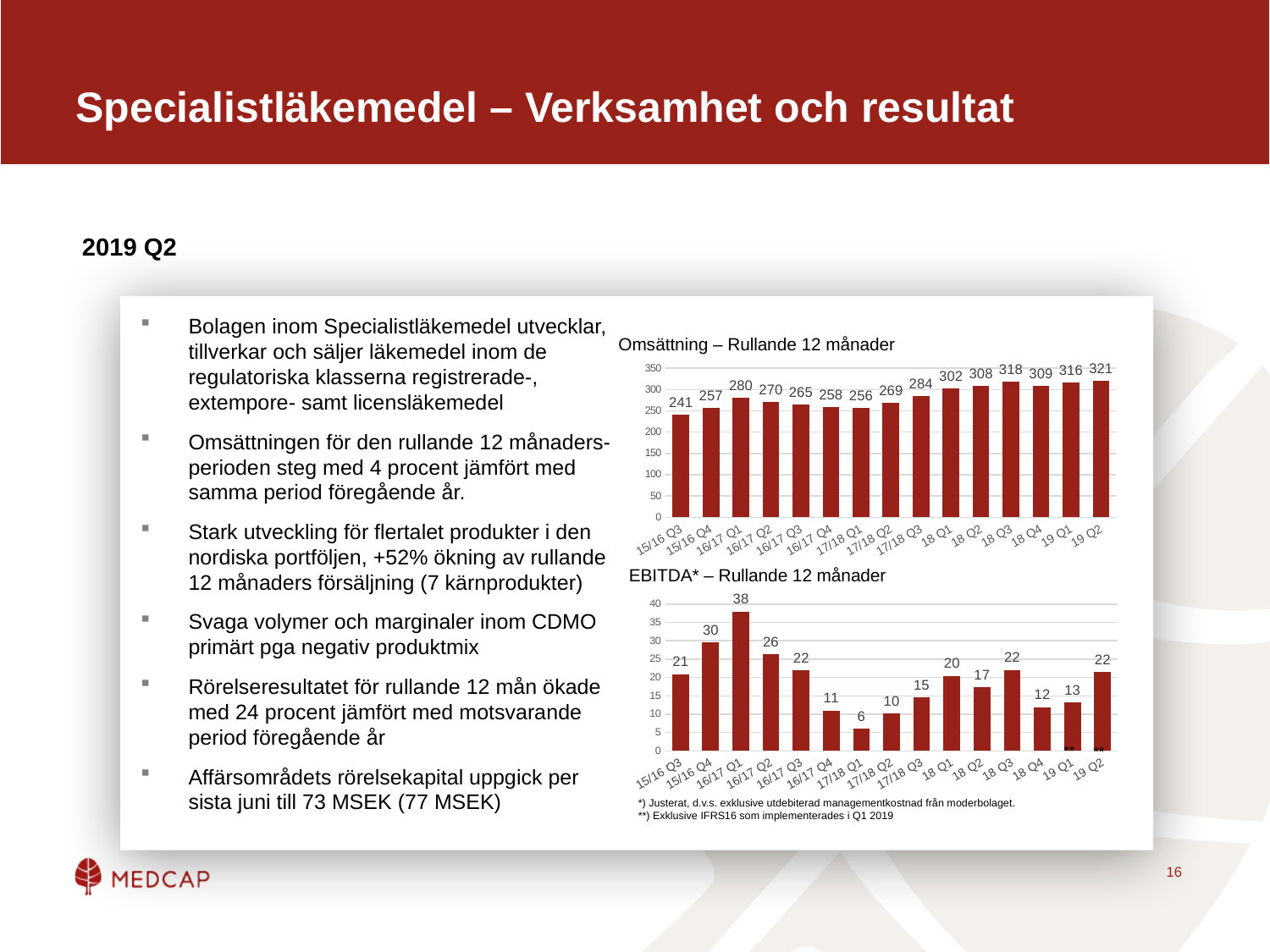
In the EBITDA* – Rullande 12 månader chart, what is the difference between 19 Q2 and 18 Q4? 10 What type of chart is the EBITDA* – Rullande 12 månader chart? Bar chart In the Omsättning – Rullande 12 månader chart, what is the value for 15/16 Q3? 241 In the Omsättning – Rullande 12 månader chart, what is the value for 19 Q2? 321 In the EBITDA* – Rullande 12 månader chart, which period has the lowest value? 17/18 Q1 In the Omsättning – Rullande 12 månader chart, is the value for 18 Q1 greater or less than 300? greater In the Omsättning – Rullande 12 månader chart, which is larger, 18 Q3 or 18 Q4? 18 Q3 In the Omsättning – Rullande 12 månader chart, which period has the lowest value? 15/16 Q3 How many bars are shown in the Omsättning – Rullande 12 månader chart? 15 In the EBITDA* – Rullande 12 månader chart, which period has the highest value? 16/17 Q1 In the Omsättning – Rullande 12 månader chart, what is the difference between 19 Q2 and 19 Q1? 5 In the EBITDA* – Rullande 12 månader chart, what is the value for 16/17 Q1? 38